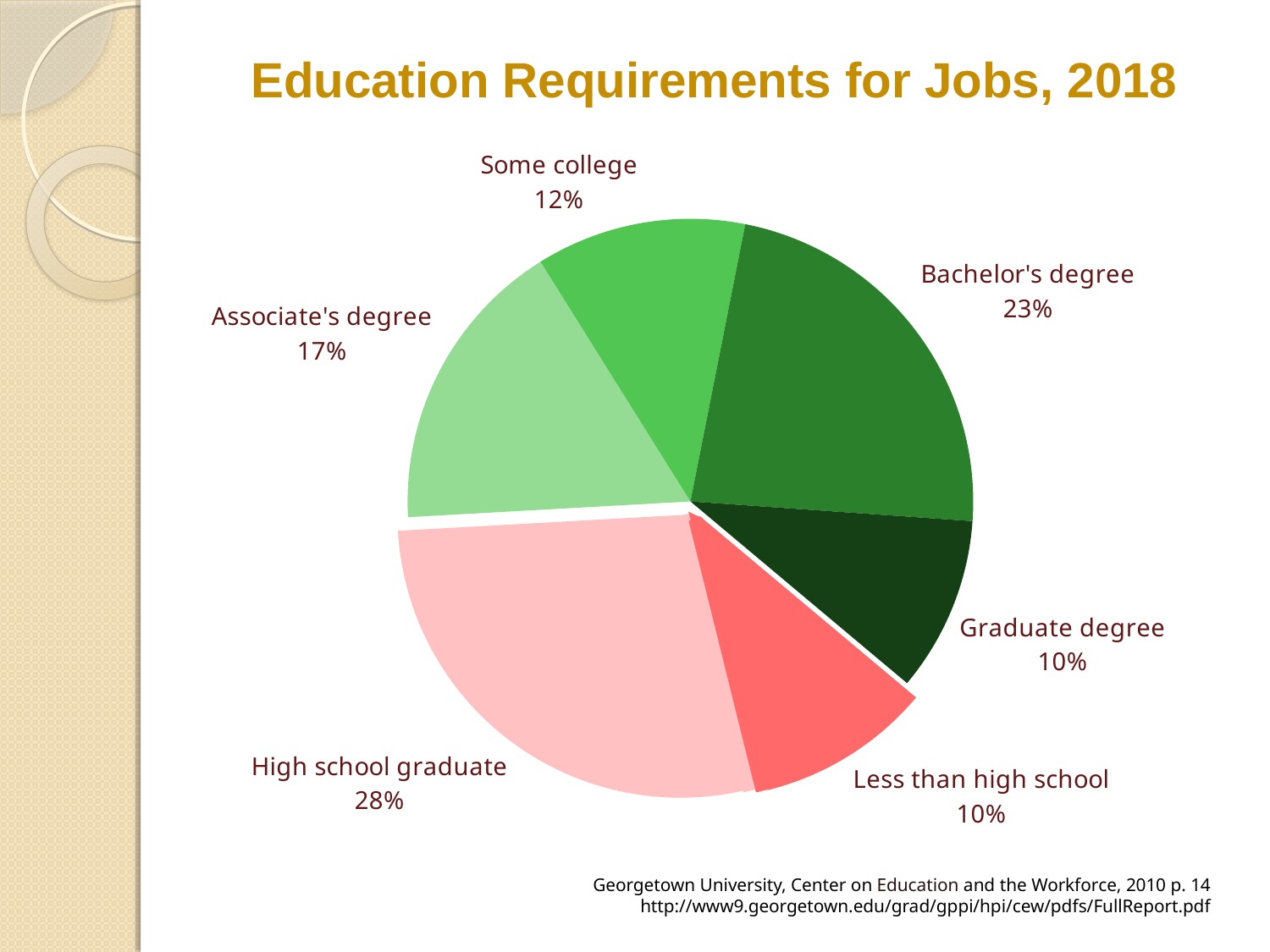
How many slices does the pie chart have? 6 Which is larger, the share for Associate's degree or the share for Some college? Associate's degree Which slice is shown in the darkest green colour? Graduate degree What share of jobs requires an Associate's degree? 17% What is the title of the chart? Education Requirements for Jobs, 2018 What share of jobs requires a graduate degree? 10% What is the combined share of jobs requiring a Bachelor's degree or a Graduate degree? 33% What share of jobs requires some college? 12% What kind of chart is shown on the slide? pie chart What is the difference between the High school graduate share and the Bachelor's degree share? 5% What share of jobs requires a Bachelor's degree? 23% Which education category has the largest share of jobs? High school graduate